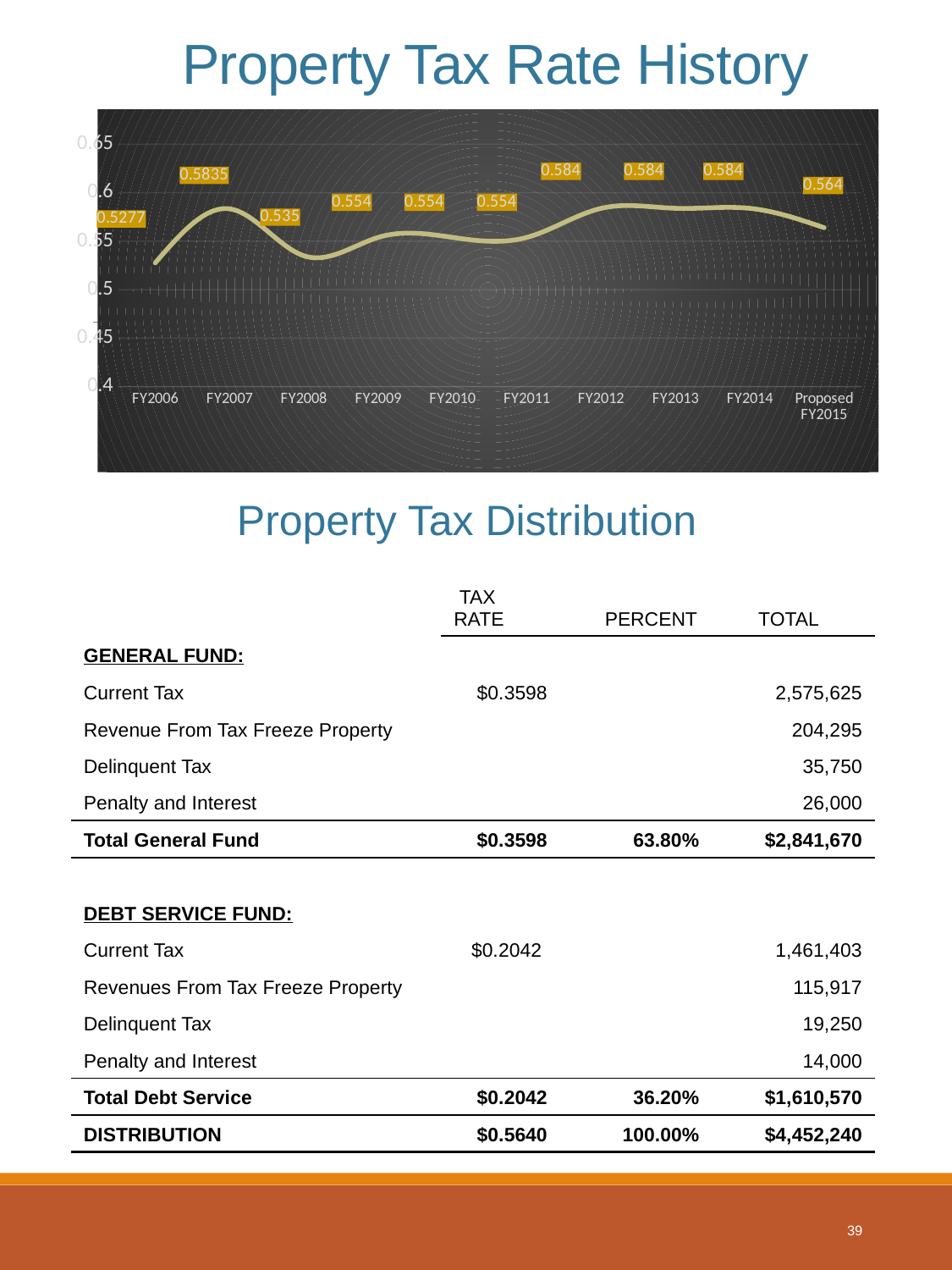
In the Property Tax Rate History chart, is the value for FY2008 greater or less than 0.55? less How many fiscal years are plotted in the Property Tax Rate History chart? 10 What kind of chart is the Property Tax Rate History chart? line chart In the Property Tax Rate History chart, how much higher is the FY2007 rate than the FY2006 rate? 0.0558 In the Property Tax Rate History chart, which is larger, the rate for FY2008 or the rate for FY2009? FY2009 Which fiscal year has the lowest property tax rate in the Property Tax Rate History chart? FY2006 What is the property tax rate shown for FY2006 in the Property Tax Rate History chart? 0.5277 What is the property tax rate shown for FY2007 in the Property Tax Rate History chart? 0.5835 In the Property Tax Rate History chart, by how much does the rate drop from FY2014 to Proposed FY2015? 0.02 What is the property tax rate shown for FY2010 in the Property Tax Rate History chart? 0.554 In the Property Tax Rate History chart, does the rate rise or fall from FY2011 to FY2012? rise What is the property tax rate shown for Proposed FY2015 in the Property Tax Rate History chart? 0.564